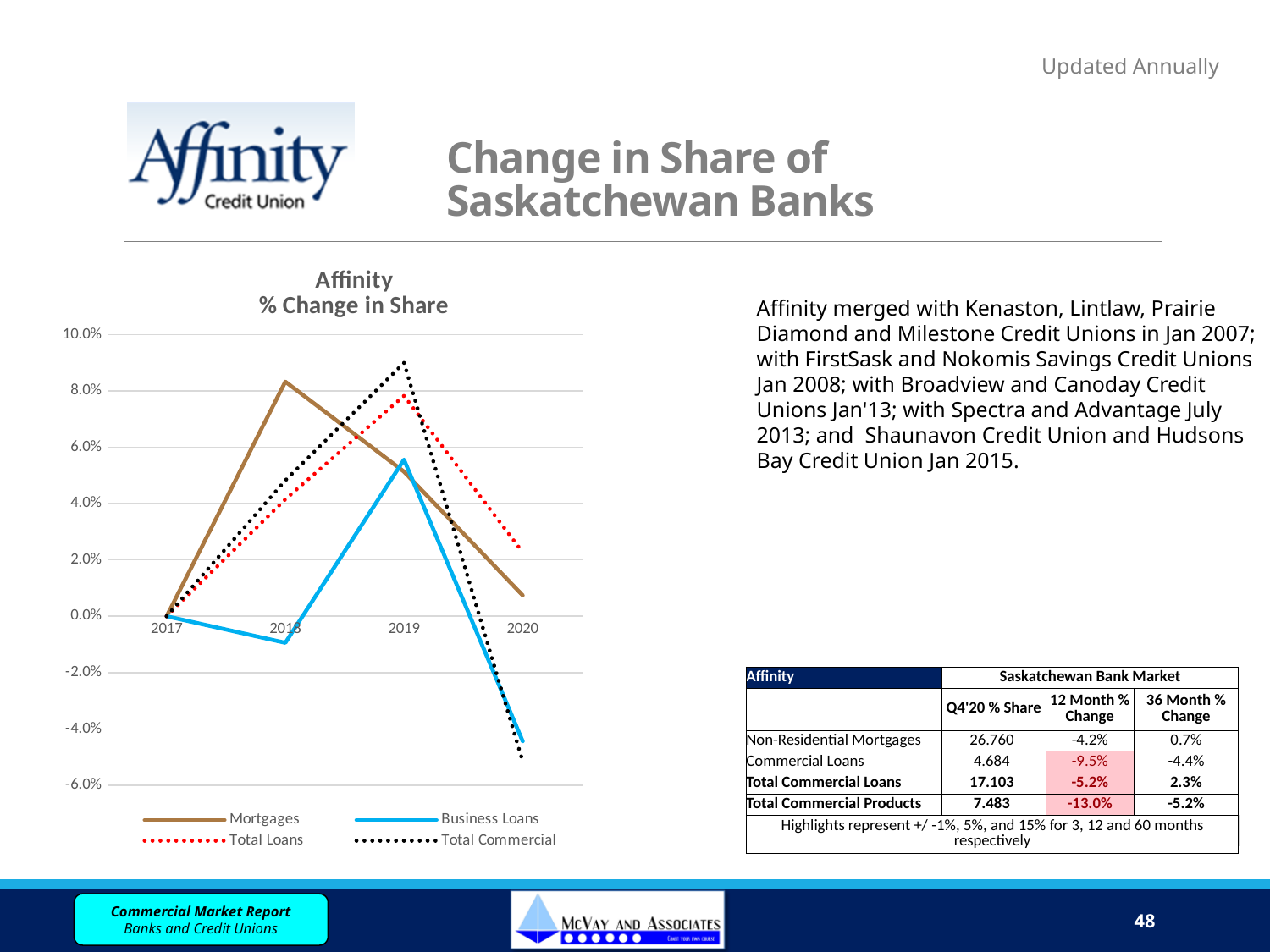
How many series does the chart legend list? 4 What is the title of the chart? Affinity % Change in Share How many years are shown on the x axis of the chart? 4 Is the value for Mortgages in 2018 greater or less than 6.0%? greater In 2018, which is larger: Mortgages or Business Loans? Mortgages Which series has the highest value in 2018? Mortgages What is the value for Mortgages in 2017? 0.0% Which series is drawn as a solid brown line in the chart? Mortgages What kind of chart is shown on the slide? line chart Does the Business Loans line rise or fall from 2019 to 2020? fall Which series has the highest value in 2019? Total Commercial Is the value for Business Loans in 2020 greater or less than -2.0%? less